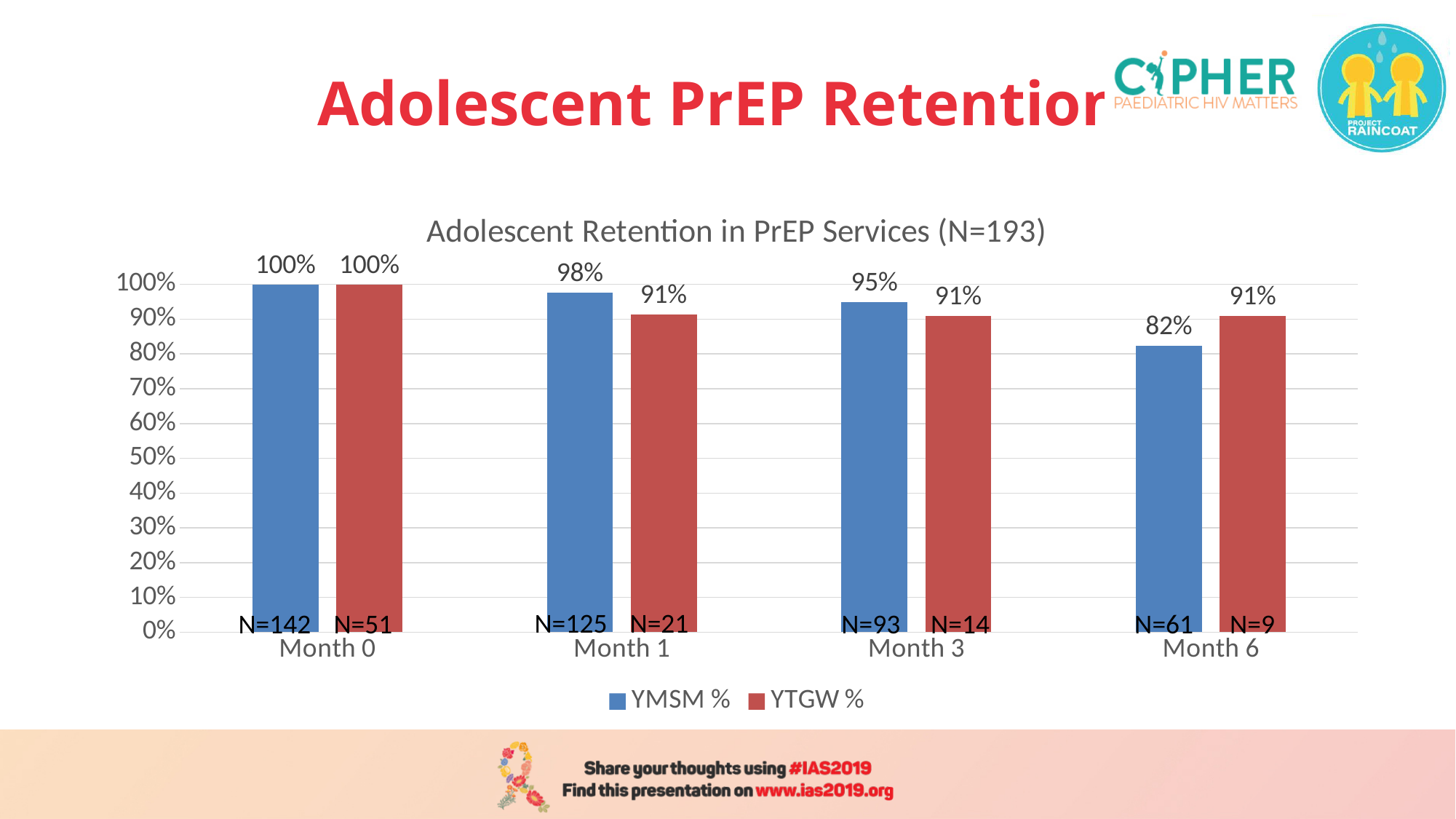
What is the YMSM % value at Month 3? 95% Does the YMSM % value rise or fall from Month 0 to Month 6? Fall What is the title of the chart? Adolescent Retention in PrEP Services (N=193) How many series does the legend list? 2 At which month is the YMSM % value lowest? Month 6 What is the difference between the YMSM % values at Month 0 and Month 6? 18% What is the YTGW % value at Month 1? 91% What kind of chart is shown on the slide? Bar chart Which is larger at Month 1, the YMSM % value or the YTGW % value? YMSM % What is the YMSM % value at Month 6? 82% What is the difference between the YMSM % and YTGW % values at Month 6? 9% How many month categories are shown on the x axis? 4